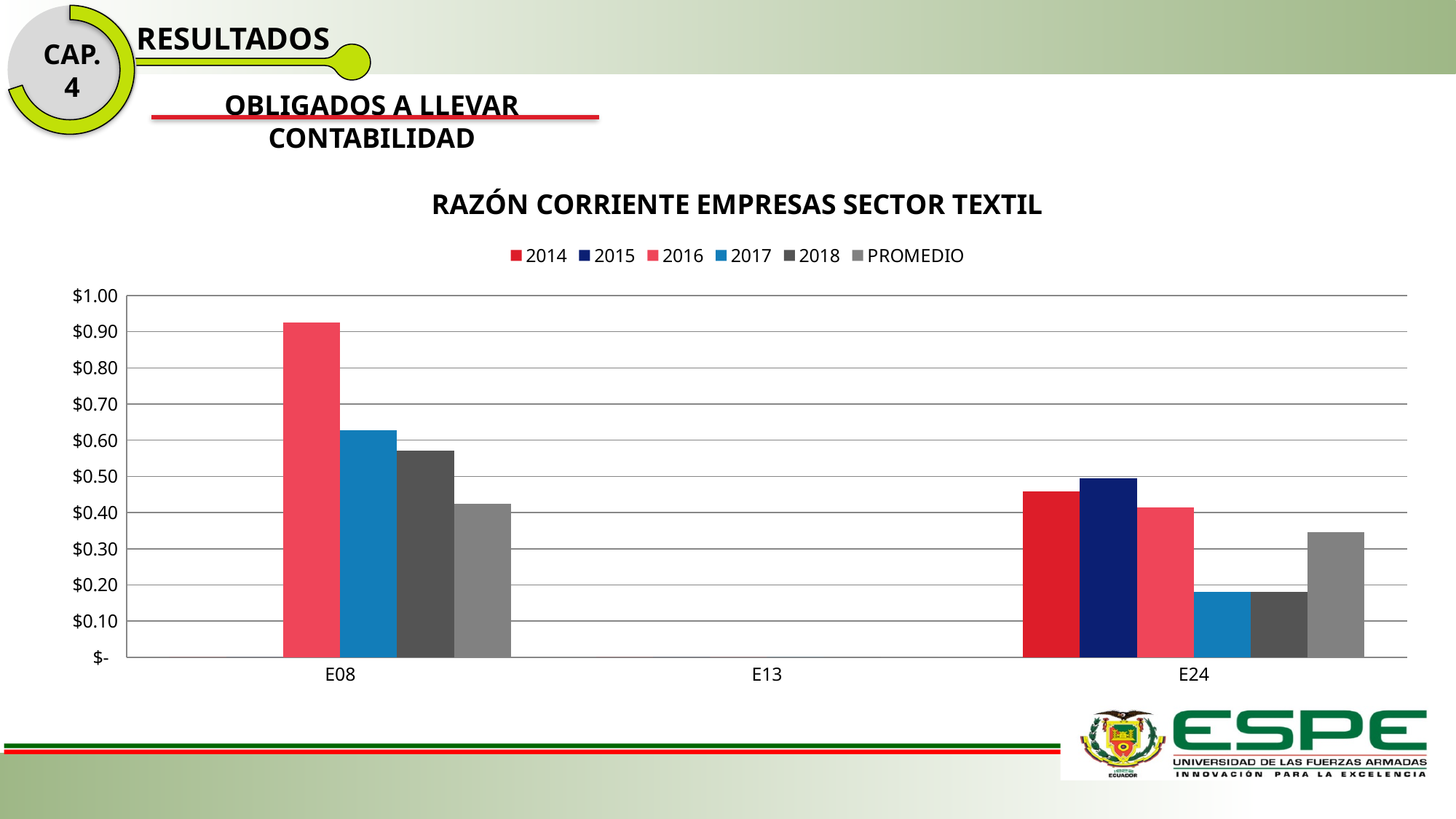
Which series has the lowest value for E08 among the bars shown? PROMEDIO Is the value for 2017 at E08 greater or less than $0.60? greater Which is larger: the 2016 value for E08 or the 2015 value for E24? the 2016 value for E08 What kind of chart is shown on the slide? bar chart Is the value for 2017 at E24 greater or less than $0.20? less Which category has the tallest bar in the chart? E08 Which series has the highest value for E08? 2016 Is the PROMEDIO value for E24 greater or less than $0.30? greater How many series does the legend list? 6 What is the title of the chart? RAZÓN CORRIENTE EMPRESAS SECTOR TEXTIL How many categories are shown on the x axis? 3